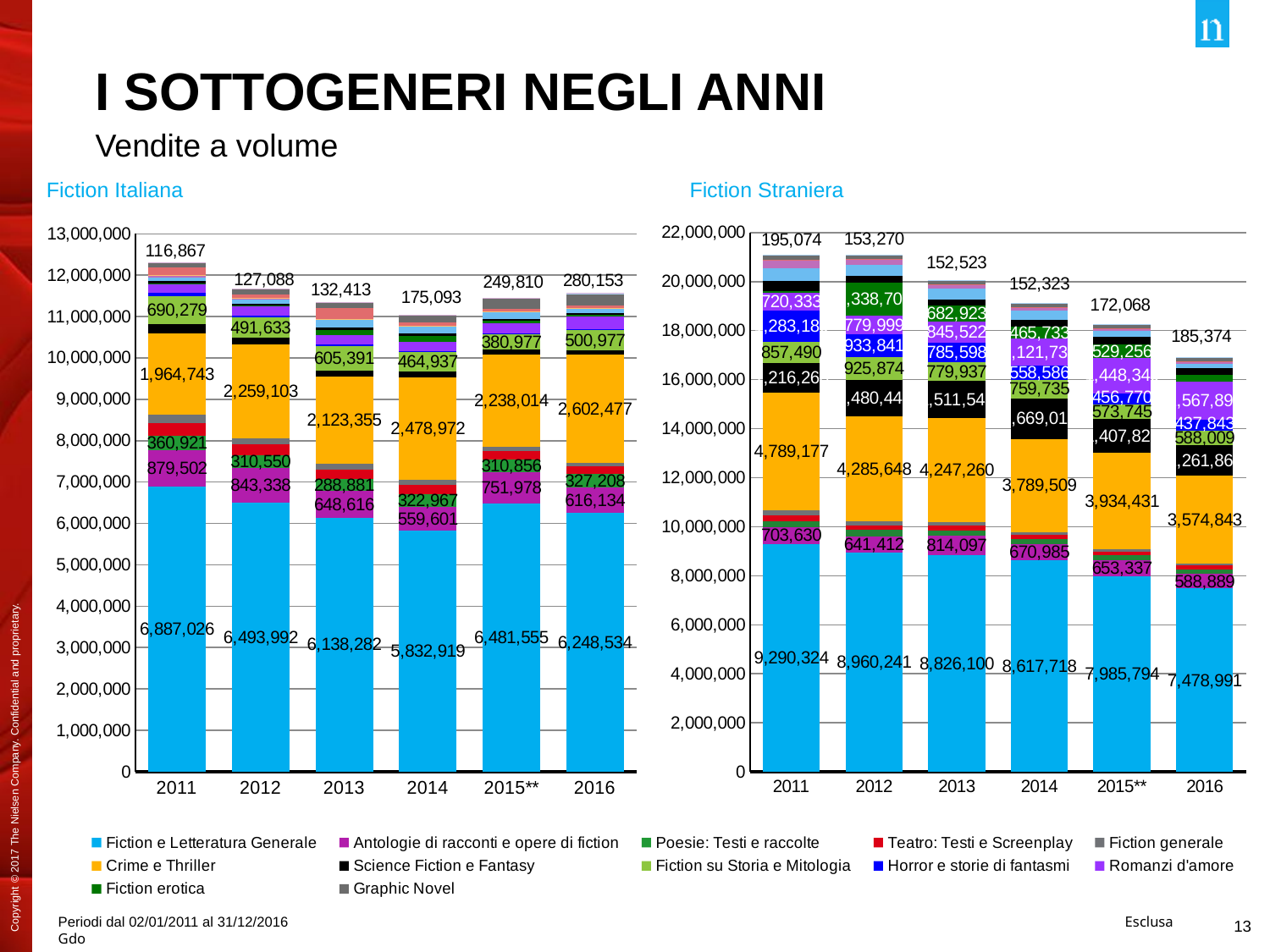
How many series does the legend list for the charts? 12 In the Fiction Straniera chart, what is the value for Fiction e Letteratura Generale in 2016? 7,478,991 In the Fiction Straniera chart, what is the difference between the Fiction e Letteratura Generale values for 2011 and 2016? 1,811,333 In the Fiction Straniera chart, which is larger for Antologie di racconti e opere di fiction: 2012 or 2013? 2013 In the Fiction Italiana chart, which year has the lowest value for Fiction e Letteratura Generale? 2014 How many years are shown on the x axis of the Fiction Italiana chart? 6 In the Fiction Italiana chart, what is the difference between the Crime e Thriller values for 2012 and 2011? 294,360 In the Fiction Italiana chart, what is the value for Fiction e Letteratura Generale in 2011? 6,887,026 In the Fiction Straniera chart, what is the value for Crime e Thriller in 2011? 4,789,177 In the Fiction Straniera chart, does the value for Fiction e Letteratura Generale rise or fall from 2011 to 2016? fall In the Fiction Italiana chart, which year has the highest value for Crime e Thriller? 2016 In the Fiction Italiana chart, what is the value for Crime e Thriller in 2016? 2,602,477